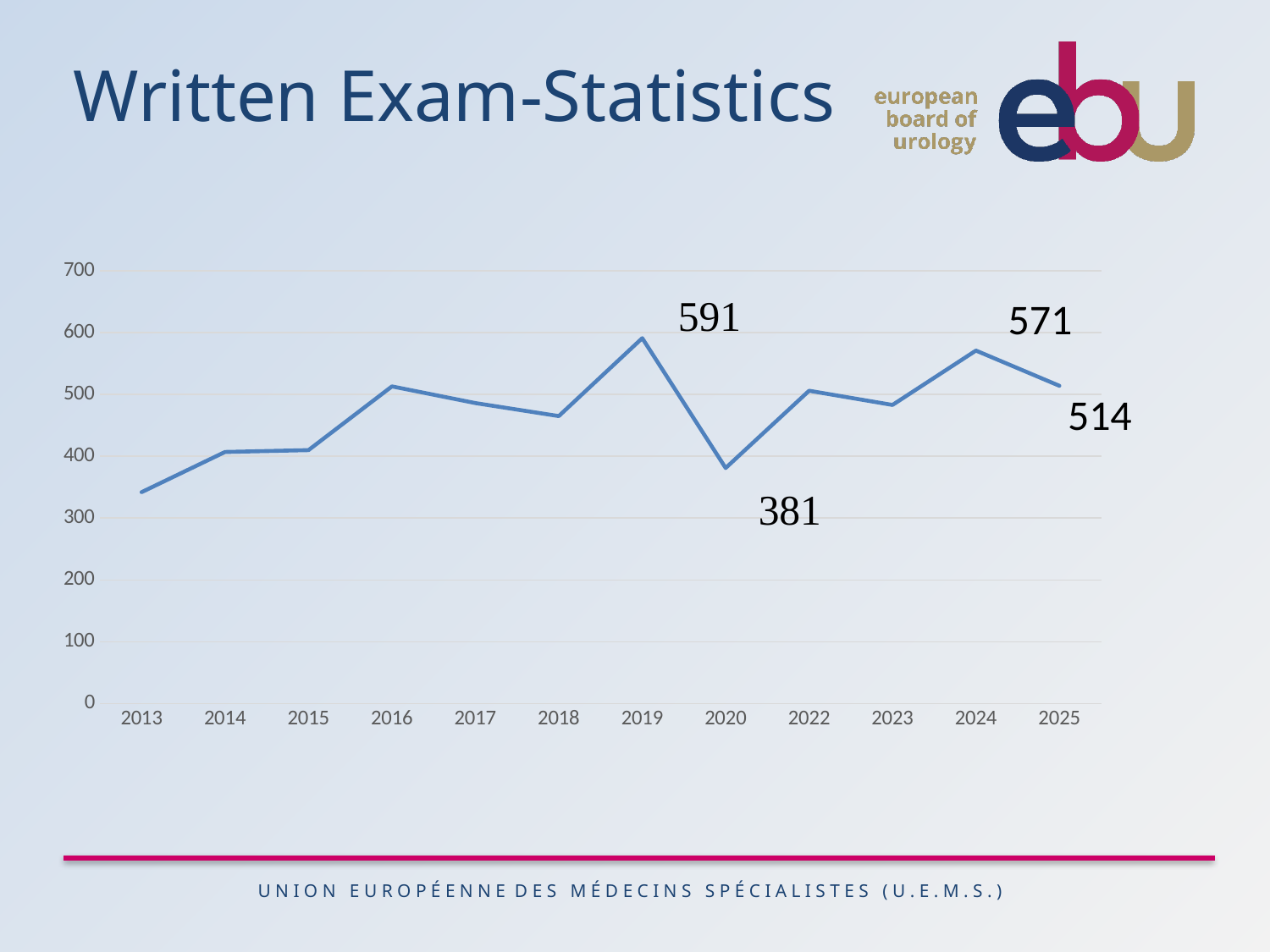
What is the difference between the values for 2019 and 2020? 210 What kind of chart is shown on the slide? line chart How many years are plotted on the x axis? 12 What is the value for 2024? 571 What is the value for 2019? 591 What is the value for 2020? 381 Is the value for 2013 greater or less than 400? less Which year has the highest value? 2019 Is the value for 2016 greater or less than 500? greater What is the difference between the values for 2024 and 2025? 57 What is the value for 2025? 514 Which is larger, the value for 2019 or the value for 2024? 2019